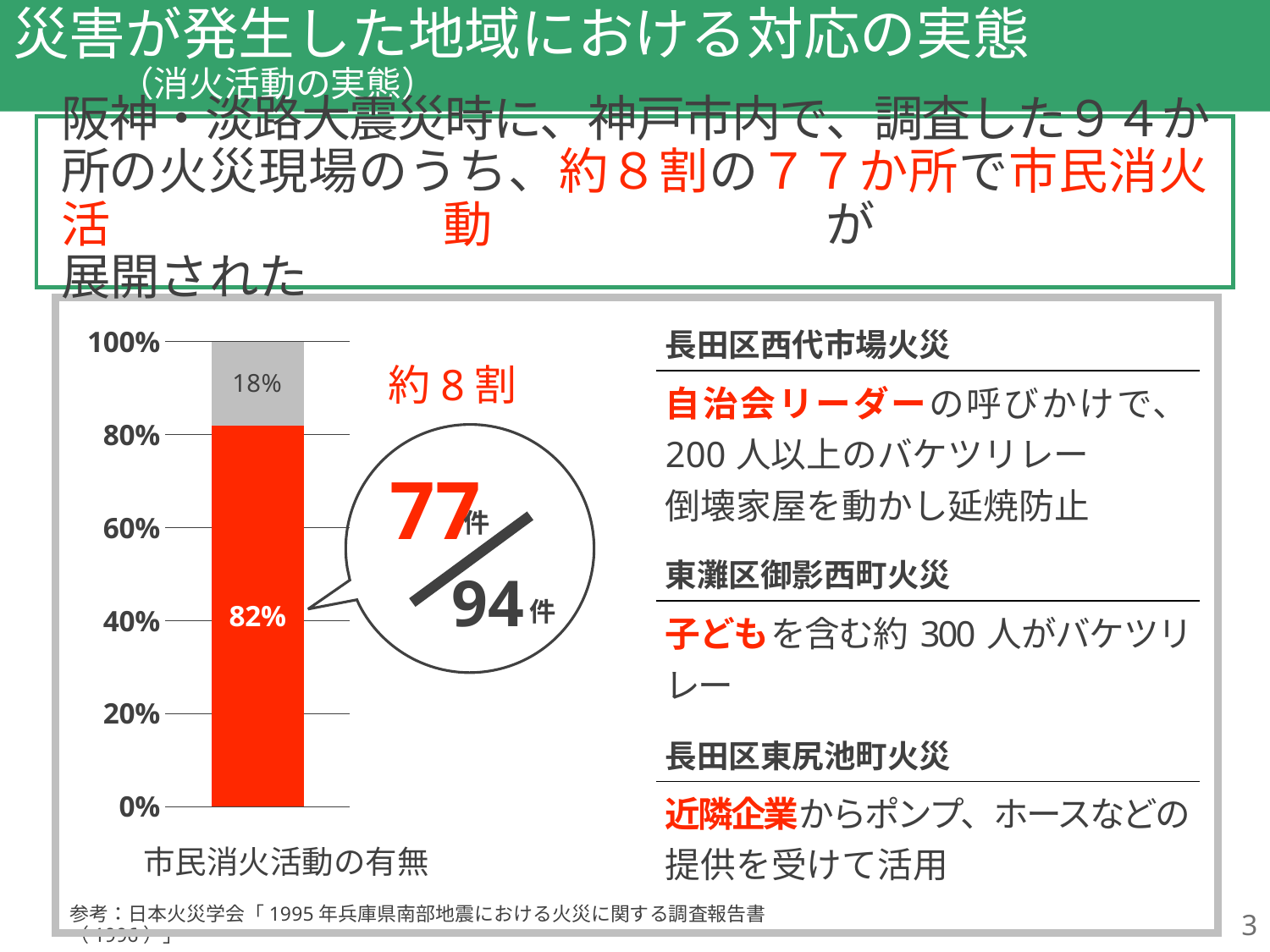
Is the value of the grey segment greater or less than 20%? less What is the highest value shown on the vertical axis? 100% What kind of chart is shown on the slide? bar chart What is the difference between the red segment (82%) and the grey segment (18%)? 64% Which segment of the bar is larger, the red one or the grey one? the red one What is the value of the grey segment at the top of the bar? 18% Is the value of the red segment greater or less than 80%? greater What is the category label shown below the bar? 市民消火活動の有無 What is the total of the stacked bar? 100% According to the callout next to the bar, how many of the 94 cases had citizen firefighting activity? 77件 What is the value of the red segment of the bar? 82% How many bars are plotted in the chart? 1